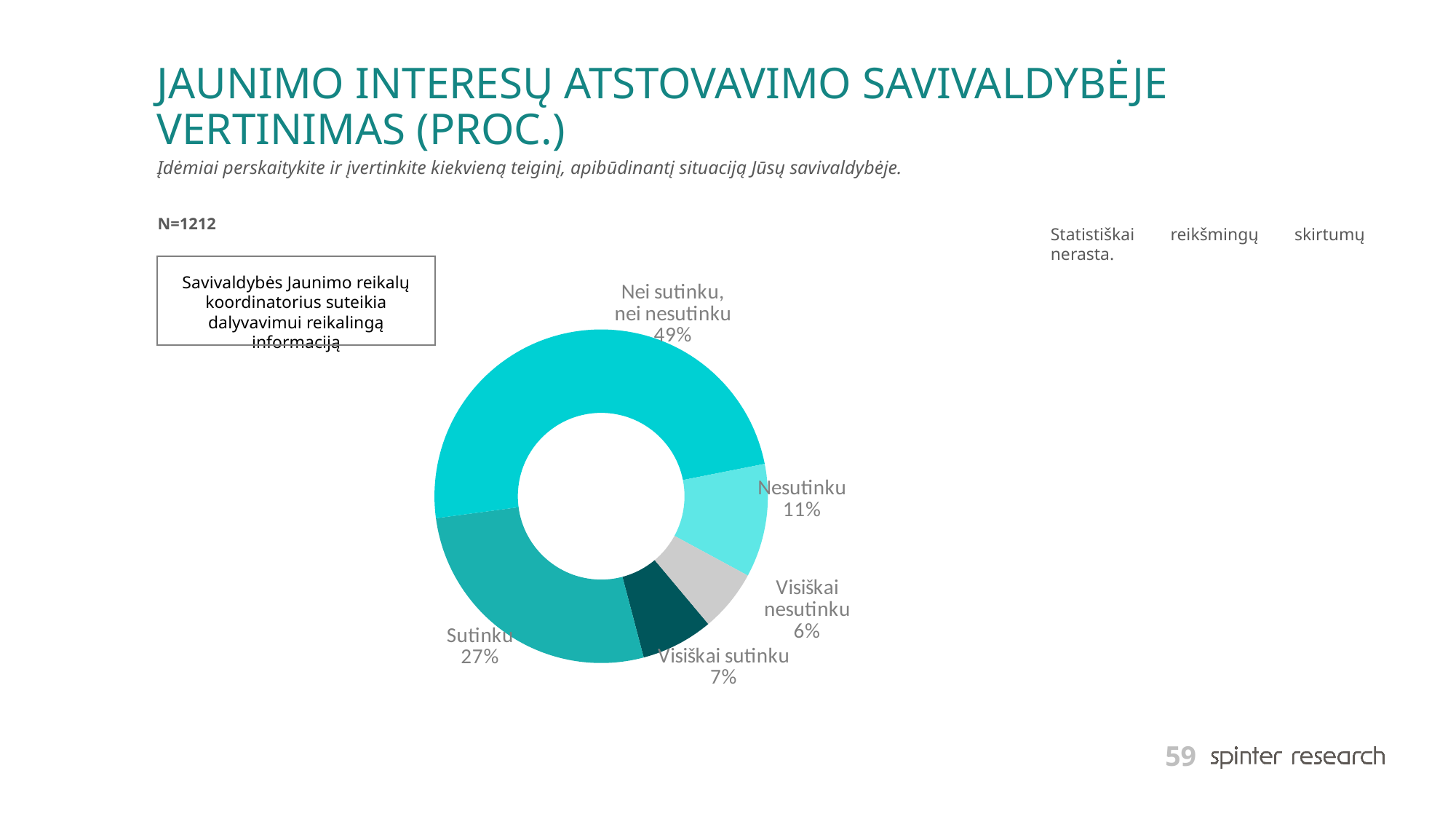
Which response category has the largest share of the chart? Nei sutinku, nei nesutinku What percentage of respondents answered "Nei sutinku, nei nesutinku"? 49% What percentage of respondents answered "Visiškai sutinku"? 7% How many response categories are shown in the chart? 5 What percentage of respondents answered "Nesutinku"? 11% What is the sample size (N) stated on the slide? N=1212 What type of chart is shown on the slide? Doughnut (pie) chart What percentage of respondents answered "Sutinku"? 27% Which response category has the smallest share of the chart? Visiškai nesutinku Which is larger: the share for "Nesutinku" or the share for "Visiškai sutinku"? Nesutinku What percentage of respondents answered "Visiškai nesutinku"? 6% What is the difference in percentage points between "Nei sutinku, nei nesutinku" and "Sutinku"? 22